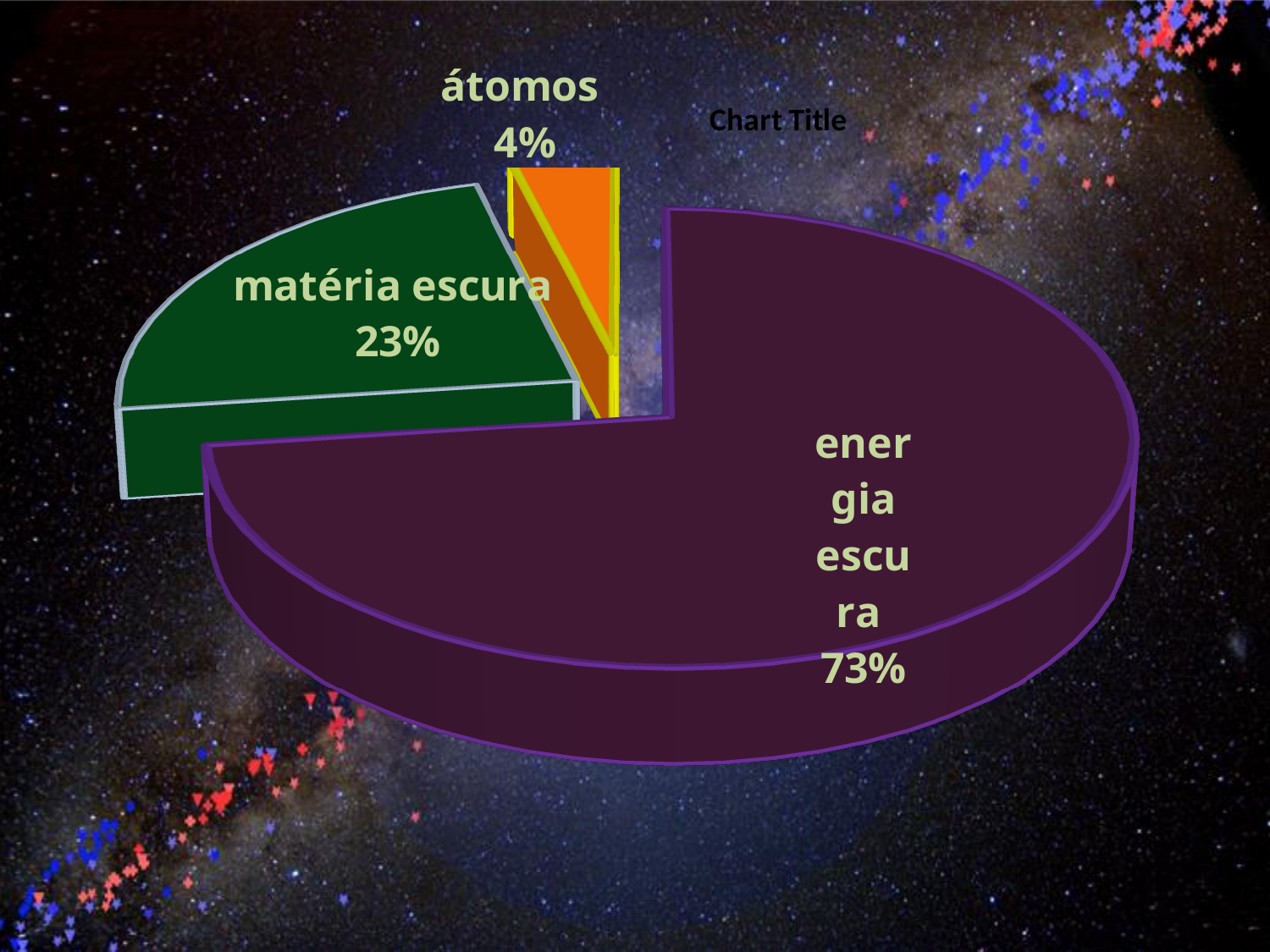
Which slice of the pie is the largest? energia escura What colour is the "matéria escura" slice? green What share of the pie does "energia escura" represent? 73% What share of the pie does "matéria escura" represent? 23% What is the difference in percentage points between "energia escura" and "matéria escura"? 50 What is the title shown on the chart? Chart Title What share of the pie does "átomos" represent? 4% How many slices does the pie chart have? 3 What kind of chart is shown on the slide? pie chart Which is larger, the share for "matéria escura" or the share for "átomos"? matéria escura What is the difference in percentage points between "matéria escura" and "átomos"? 19 Which slice of the pie is the smallest? átomos